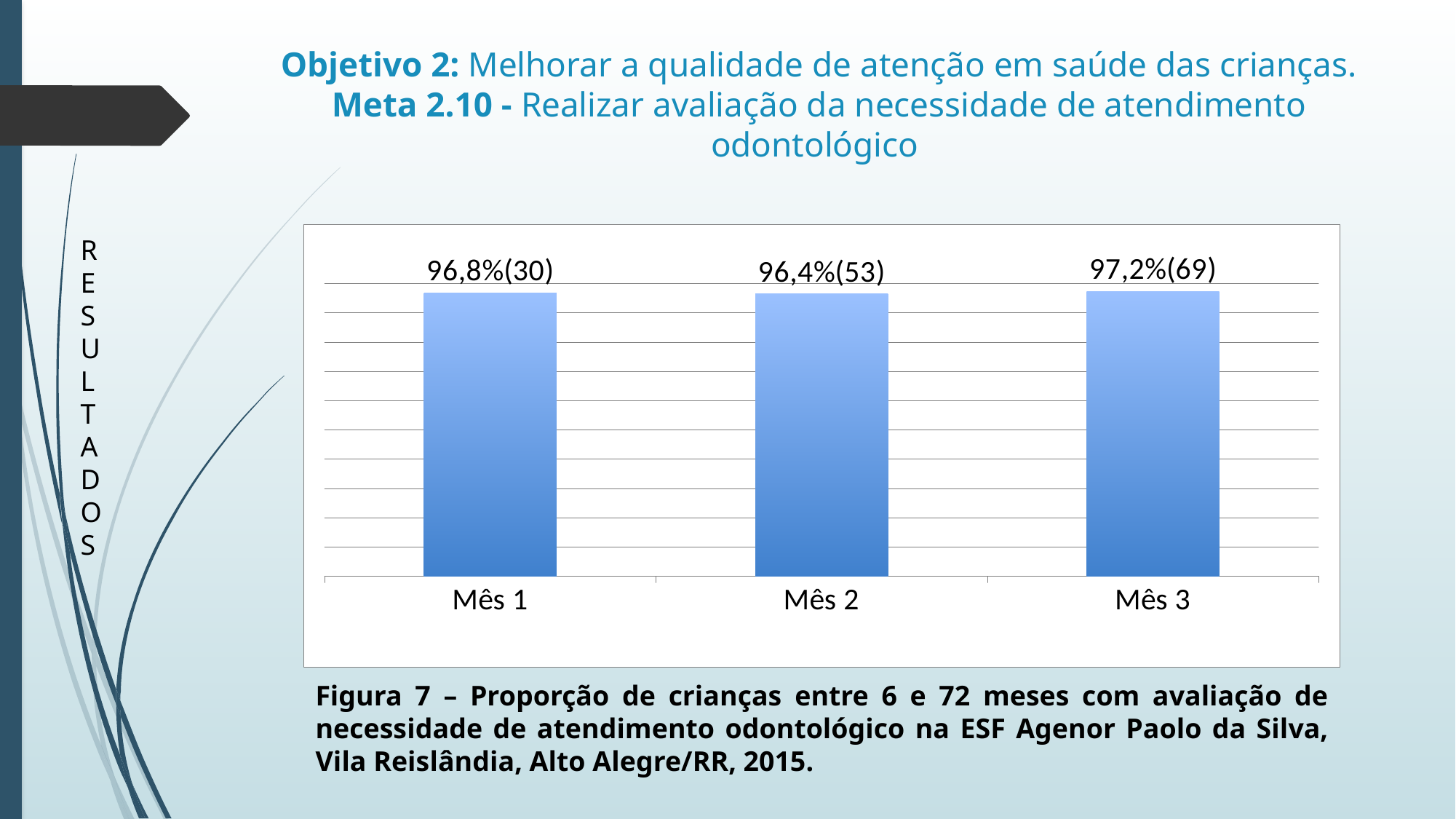
Which month has the lowest percentage according to the data labels? Mês 2 What kind of chart is shown on the slide? Bar chart What figure number is given in the caption below the chart? Figura 7 How many more children are shown in parentheses for Mês 3 than for Mês 1? 39 Which has the higher percentage, Mês 1 or Mês 2? Mês 1 Which month has the highest percentage according to the data labels? Mês 3 What is the data label shown for Mês 2? 96,4%(53) What percentage is shown for Mês 2? 96,4% What is the data label shown for Mês 3? 97,2%(69) How many children are shown in parentheses for Mês 3? 69 How many months (categories) are shown on the x axis? 3 What is the data label shown for Mês 1? 96,8%(30)